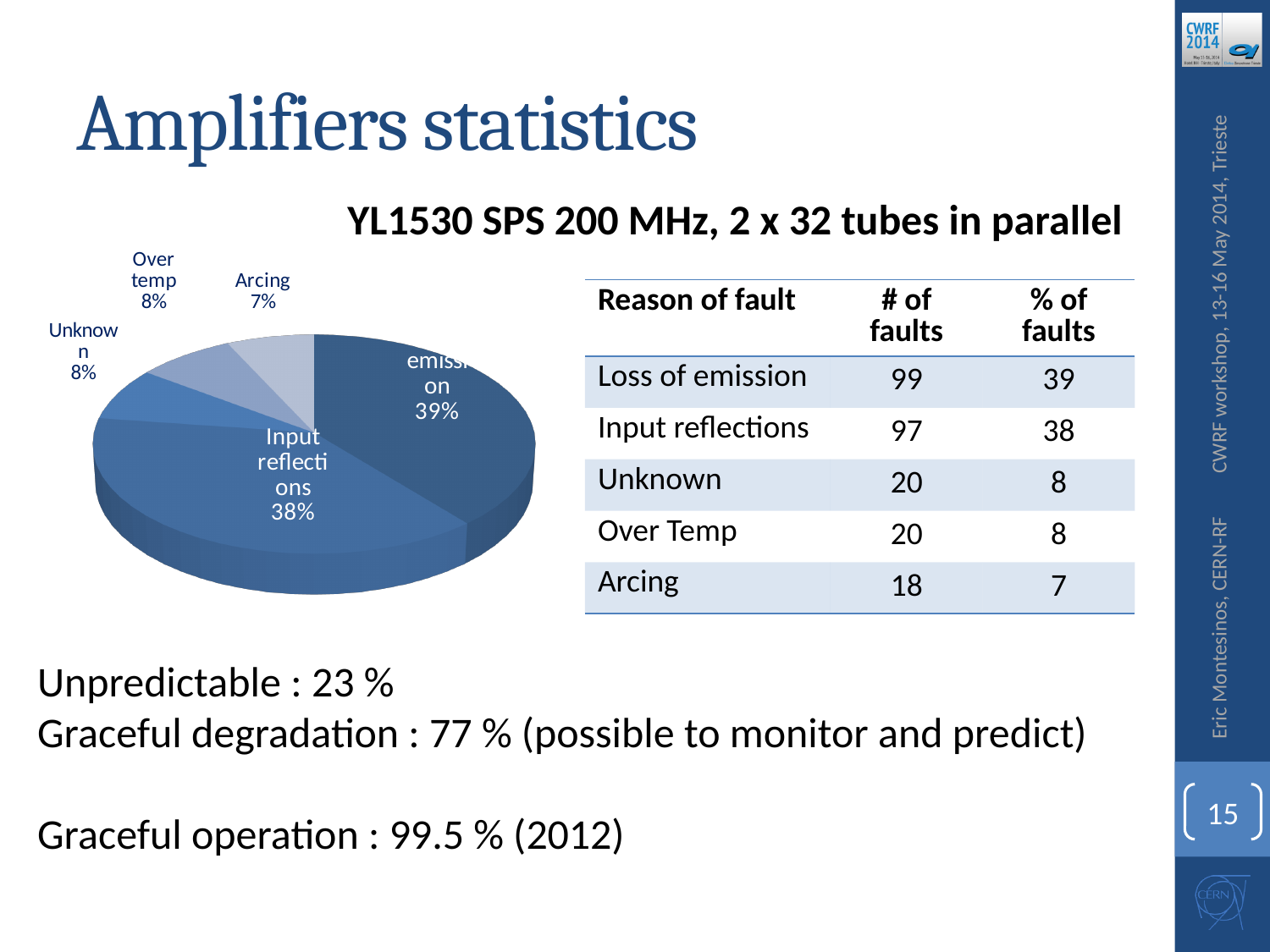
What share of the pie does Input reflections have? 38% What share of the pie does Unknown have? 8% Which slice of the pie chart is the largest? Loss of emission Which slice of the pie chart is the smallest? Arcing What is the combined share of the Unknown and Over temp slices? 16% What share of the pie does Over temp have? 8% What is the title printed above the pie chart and table? YL1530 SPS 200 MHz, 2 x 32 tubes in parallel What kind of chart is shown on the slide? pie chart How many slices does the pie chart have? 5 Which is larger in the pie chart, Input reflections or Unknown? Input reflections What is the difference in percentage points between the Input reflections slice and the Arcing slice? 31